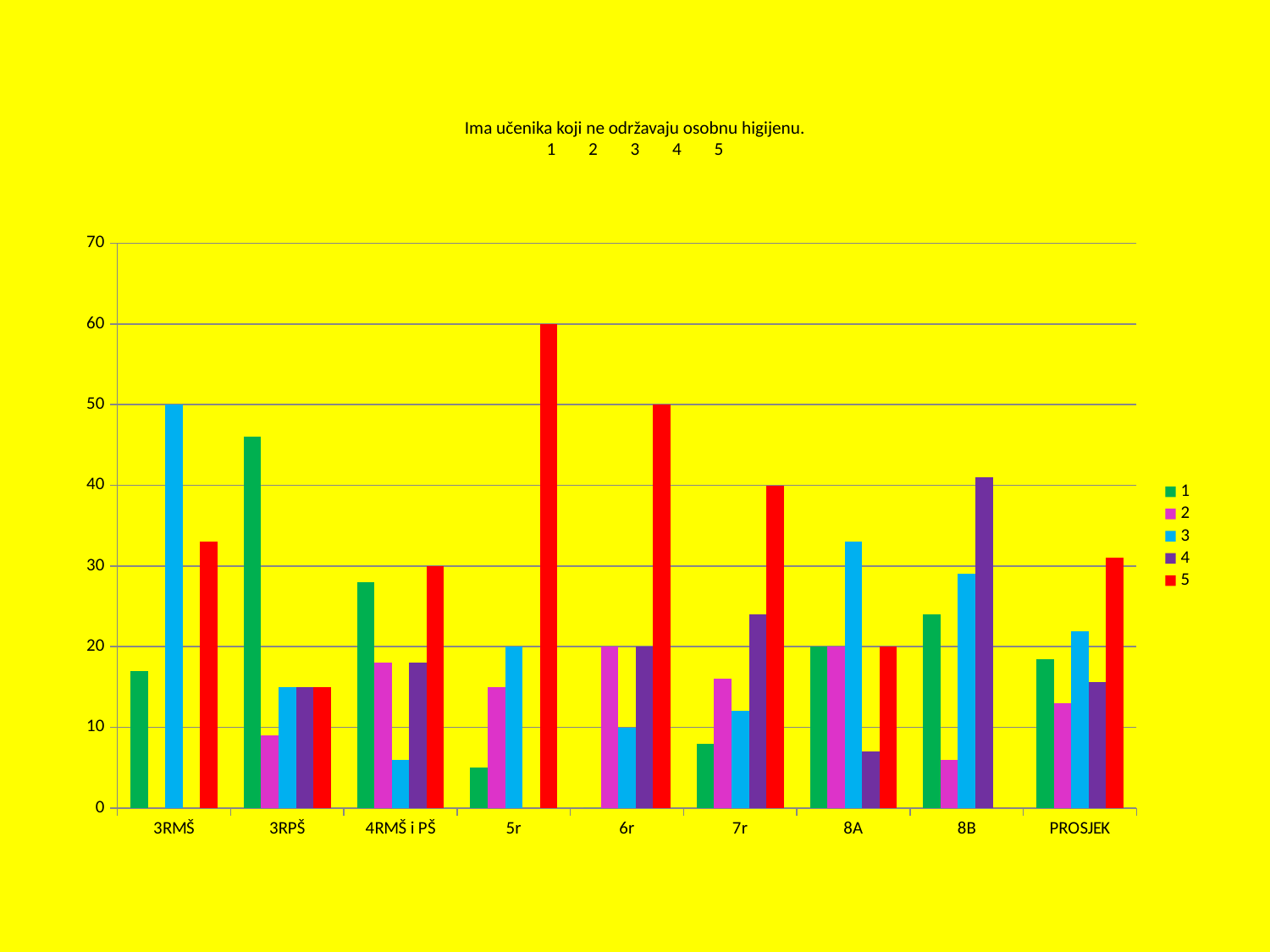
What is the value of series 3 for 3RMŠ? 50 How many series does the legend list? 5 Which category has the tallest bar in the whole chart? 5r What is the value of series 5 for 7r? 40 Is the value of series 1 for 3RPŠ greater or less than 40? greater How many categories are shown along the x axis? 9 What is the value of series 5 for 6r? 50 Which series is shown in red in the legend? 5 What kind of chart is shown on the slide? bar chart What is the value of series 5 for 5r? 60 Which is larger for 8B: series 1 or series 3? series 3